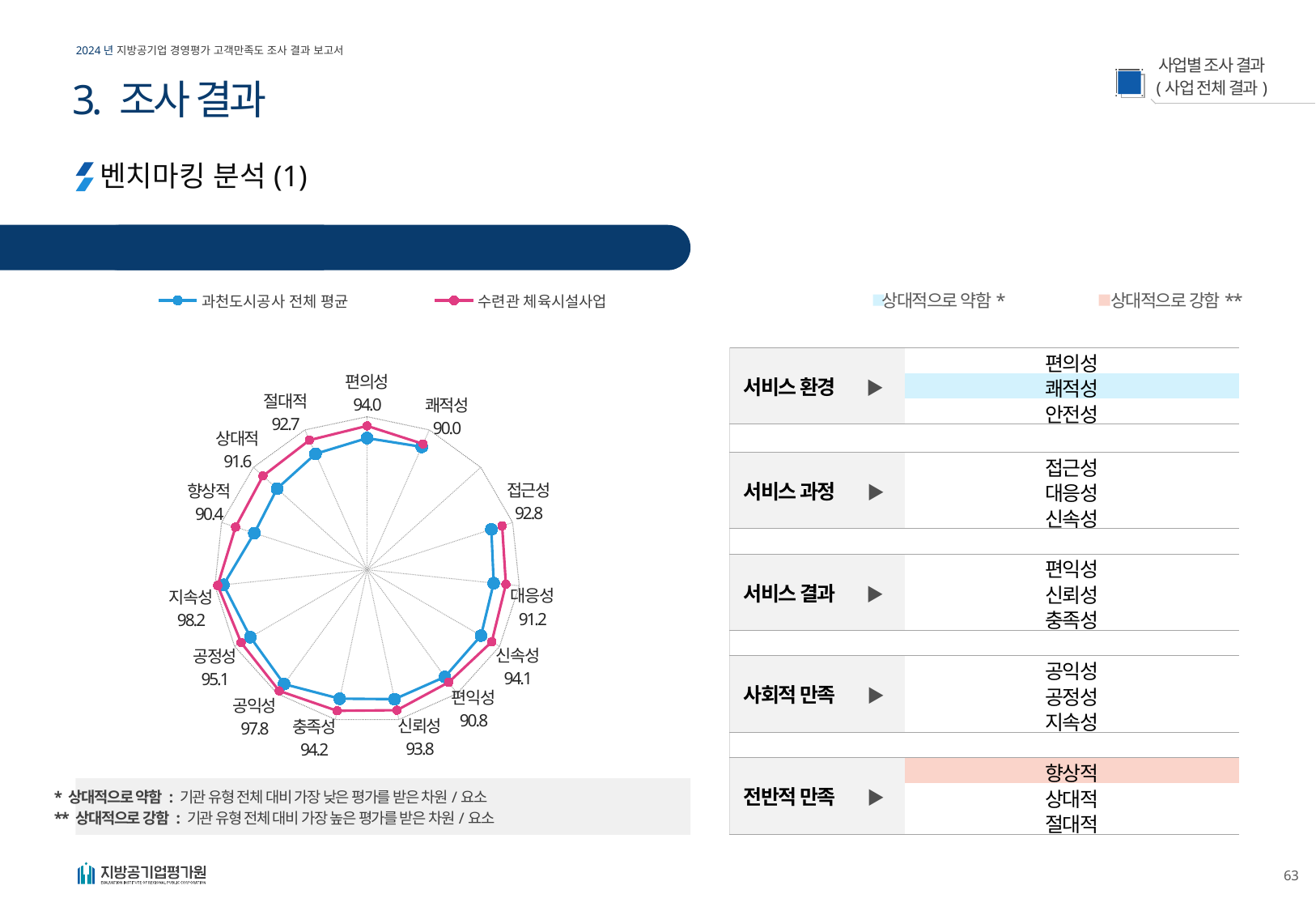
What value is printed next to 쾌적성 on the radar chart? 90.0 What value is printed next to 지속성 on the radar chart? 98.2 What kind of chart is shown on the slide? radar chart Which category has the lowest printed value on the radar chart? 쾌적성 How many categories (axes) does the radar chart have? 15 What is the difference between the printed values for 지속성 and 쾌적성 on the radar chart? 8.2 How many series does the legend of the radar chart list? 2 What value is printed next to 편의성 on the radar chart? 94.0 Which has the larger printed value on the radar chart, 공익성 or 공정성? 공익성 What value is printed next to 공익성 on the radar chart? 97.8 Which series is shown in blue in the radar chart legend? 과천도시공사 전체 평균 Which category has the highest printed value on the radar chart? 지속성